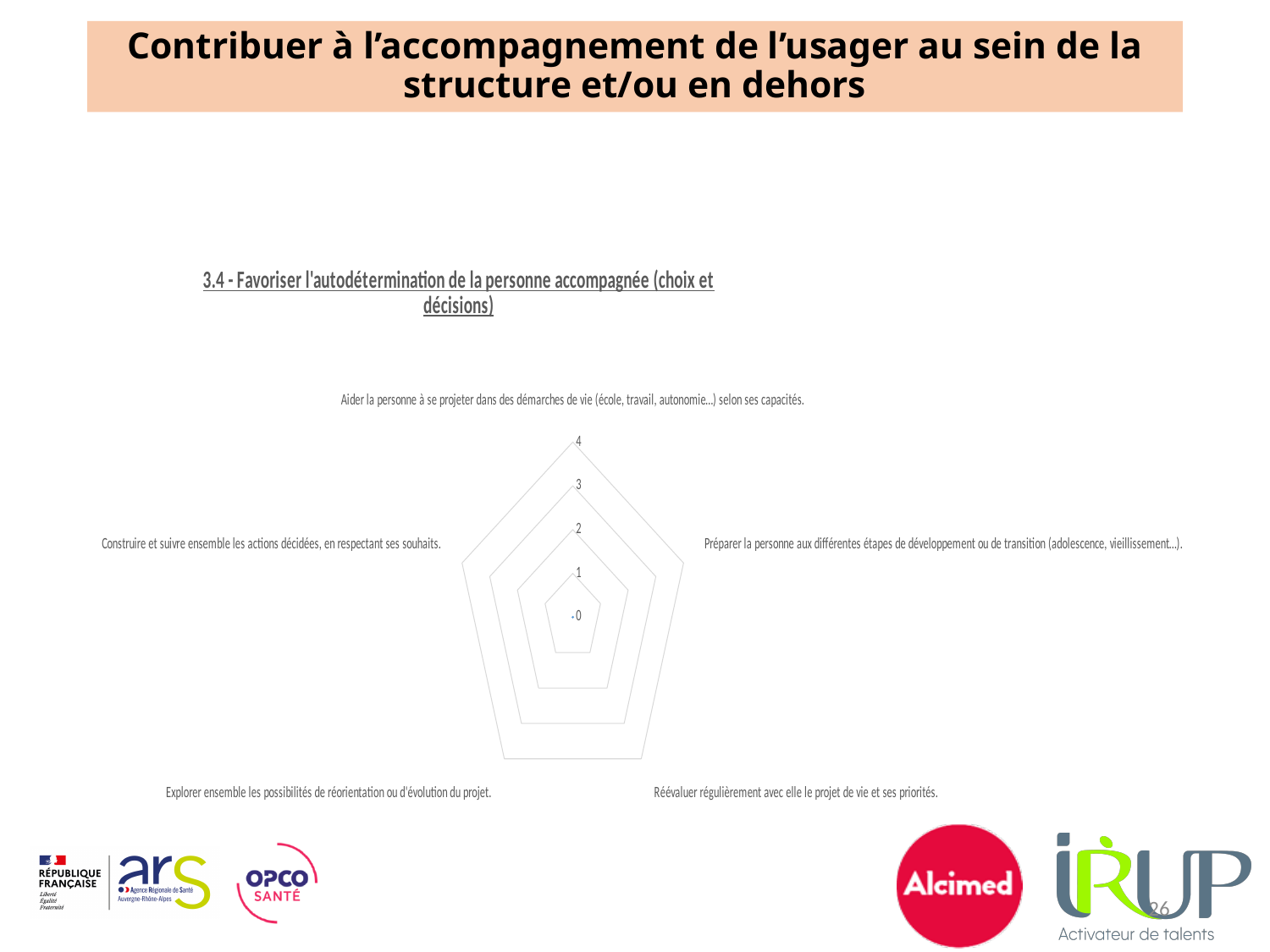
What is the highest tick value shown on the radar chart's axis? 4 How many categories (axes) does the radar chart have? 5 Which category label appears at the bottom right of the radar chart? Réévaluer régulièrement avec elle le projet de vie et ses priorités. What is the lowest tick value shown on the radar chart's axis? 0 What is the title of the radar chart? 3.4 - Favoriser l'autodétermination de la personne accompagnée (choix et décisions) Which category label appears on the left side of the radar chart? Construire et suivre ensemble les actions décidées, en respectant ses souhaits. Which category label appears on the right side of the radar chart? Préparer la personne aux différentes étapes de développement ou de transition (adolescence, vieillissement...). What kind of chart is shown on the slide? Radar chart Which category label appears at the top of the radar chart? Aider la personne à se projeter dans des démarches de vie (école, travail, autonomie...) selon ses capacités. Which category label appears at the bottom left of the radar chart? Explorer ensemble les possibilités de réorientation ou d'évolution du projet.